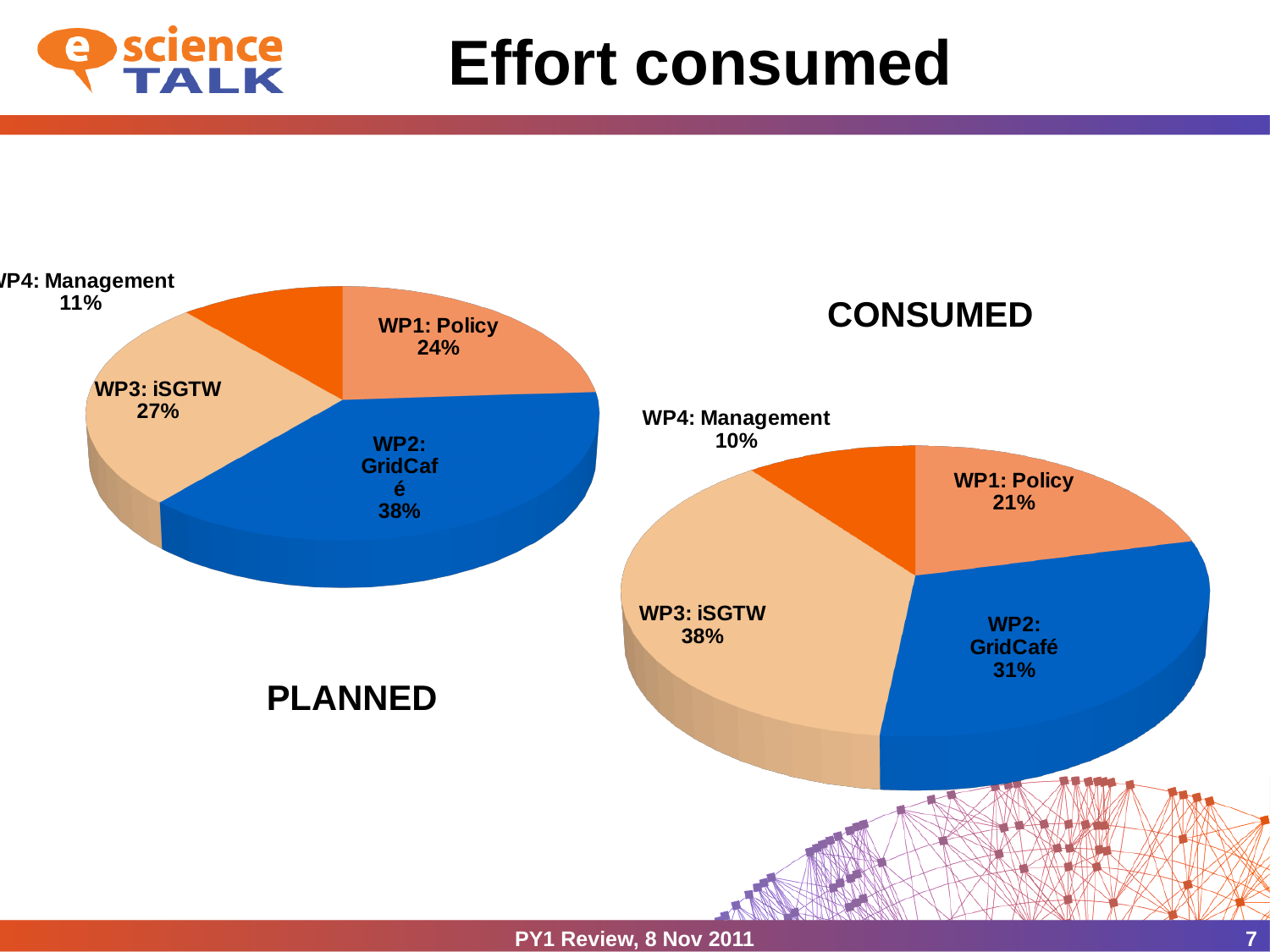
In the PLANNED pie chart, which work package has the largest share? WP2: GridCafé How many slices does the PLANNED pie chart have? 4 In the PLANNED pie chart, what share does WP2: GridCafé have? 38% In the PLANNED pie chart, what is the difference between the shares of WP2: GridCafé and WP1: Policy? 14% Is the share of WP3: iSGTW larger in the PLANNED chart or the CONSUMED chart? CONSUMED In the CONSUMED pie chart, which work package has the largest share? WP3: iSGTW In the CONSUMED pie chart, what is the value for WP1: Policy? 21% In the CONSUMED pie chart, what is the difference between the shares of WP3: iSGTW and WP2: GridCafé? 7% In the CONSUMED pie chart, which work package has the smallest share? WP4: Management What type of chart is used for the CONSUMED chart? Pie chart In the PLANNED pie chart, what is the value for WP4: Management? 11% In the CONSUMED pie chart, what share does WP3: iSGTW have? 38%